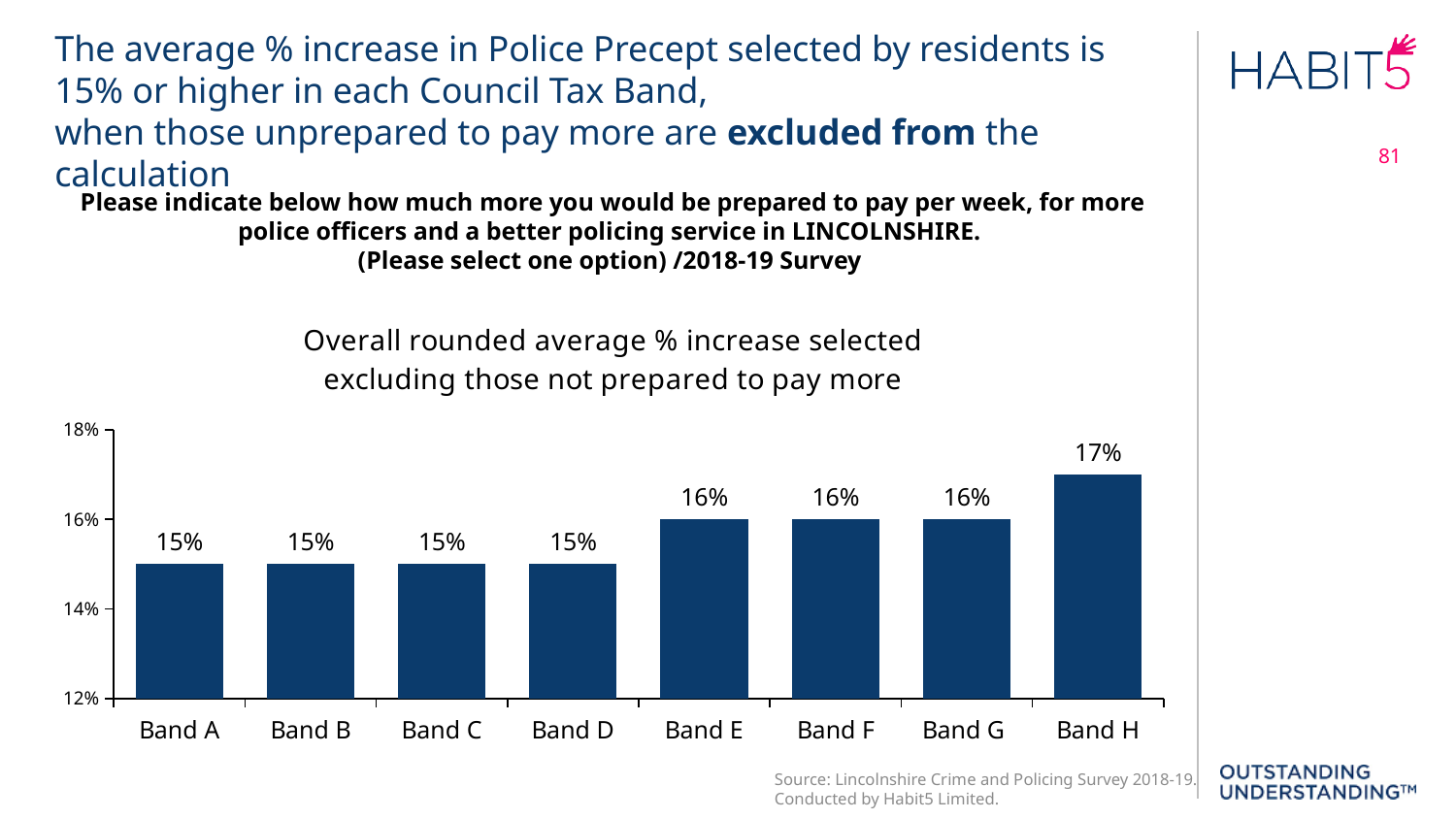
What is the overall rounded average % increase selected for Band A? 15% What is the difference between the values for Band H and Band D? 2% Which Council Tax Band has the highest average % increase selected? Band H What is the title of the chart? Overall rounded average % increase selected excluding those not prepared to pay more Do the values rise or fall moving from Band A to Band H along the x axis? Rise What kind of chart is shown on the slide? Bar chart What is the overall rounded average % increase selected for Band F? 16% What is the difference between the values for Band E and Band C? 1% Is the value for Band H greater or less than 16%? greater How many Council Tax Bands are shown on the chart? 8 What is the overall rounded average % increase selected for Band H? 17% Which is larger, the value for Band G or the value for Band B? Band G